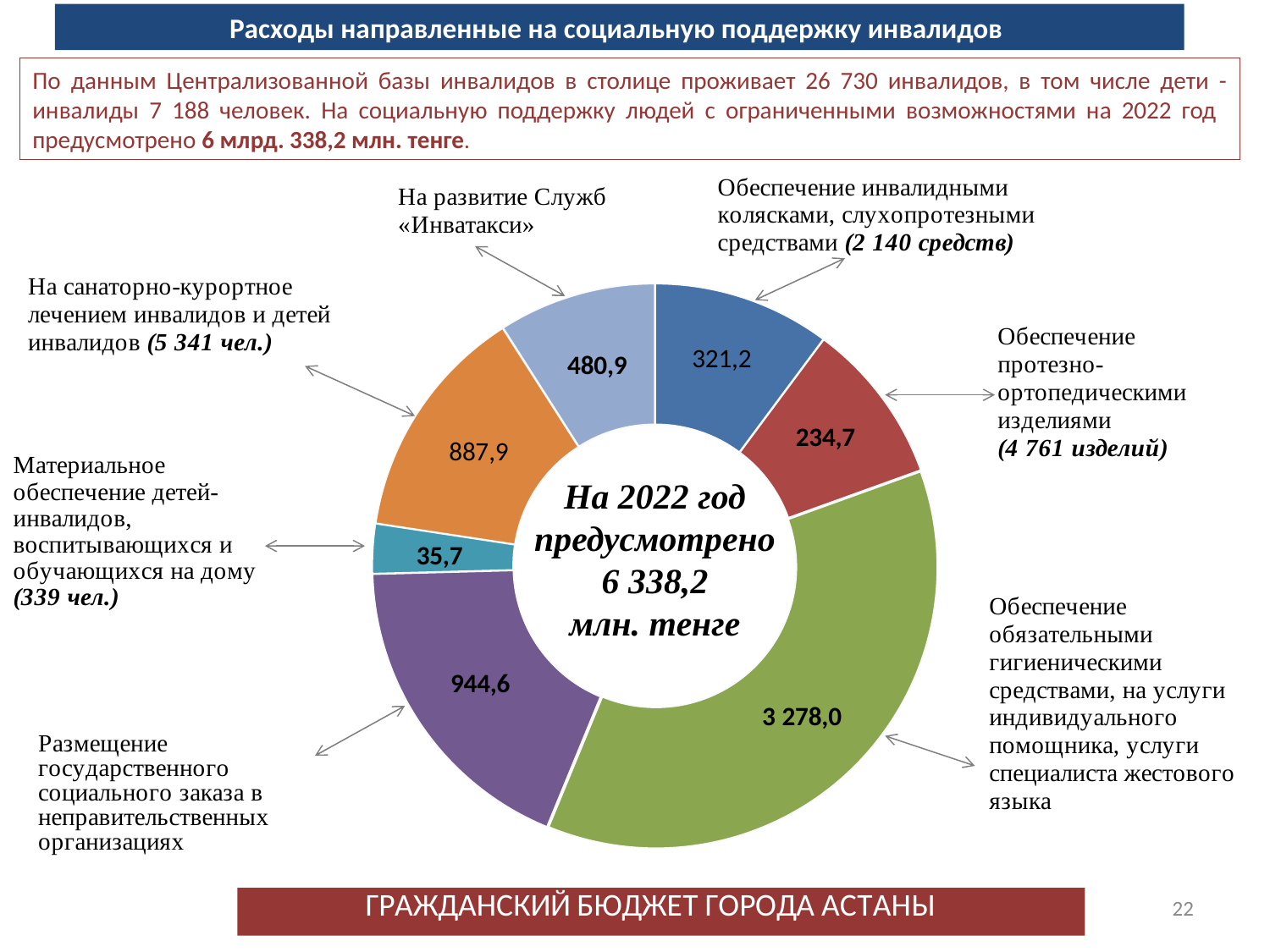
What is the value for 'Обеспечение протезно-ортопедическими изделиями'? 234,7 What is the value for 'Размещение государственного социального заказа в неправительственных организациях'? 944,6 Which segment has the smallest value? Материальное обеспечение детей-инвалидов, воспитывающихся и обучающихся на дому (35,7) How many segments does the doughnut chart have? 7 What total amount is stated in the centre of the doughnut chart for 2022? 6 338,2 млн. тенге What is the value for 'Материальное обеспечение детей-инвалидов, воспитывающихся и обучающихся на дому'? 35,7 What type of chart is shown on the slide? doughnut chart What is the value (млн. тенге) for the segment 'На развитие Служб «Инватакси»'? 480,9 Which is larger: the value for 'На развитие Служб «Инватакси»' or the value for 'Обеспечение инвалидными колясками, слухопротезными средствами'? На развитие Служб «Инватакси» (480,9) What is the difference between the value for 'Размещение государственного социального заказа в неправительственных организациях' and the value for 'На санаторно-курортное лечением инвалидов и детей инвалидов'? 56,7 What is the title of the slide above the chart? Расходы направленные на социальную поддержку инвалидов Which segment has the largest value? Обеспечение обязательными гигиеническими средствами, на услуги индивидуального помощника, услуги специалиста жестового языка (3 278,0)